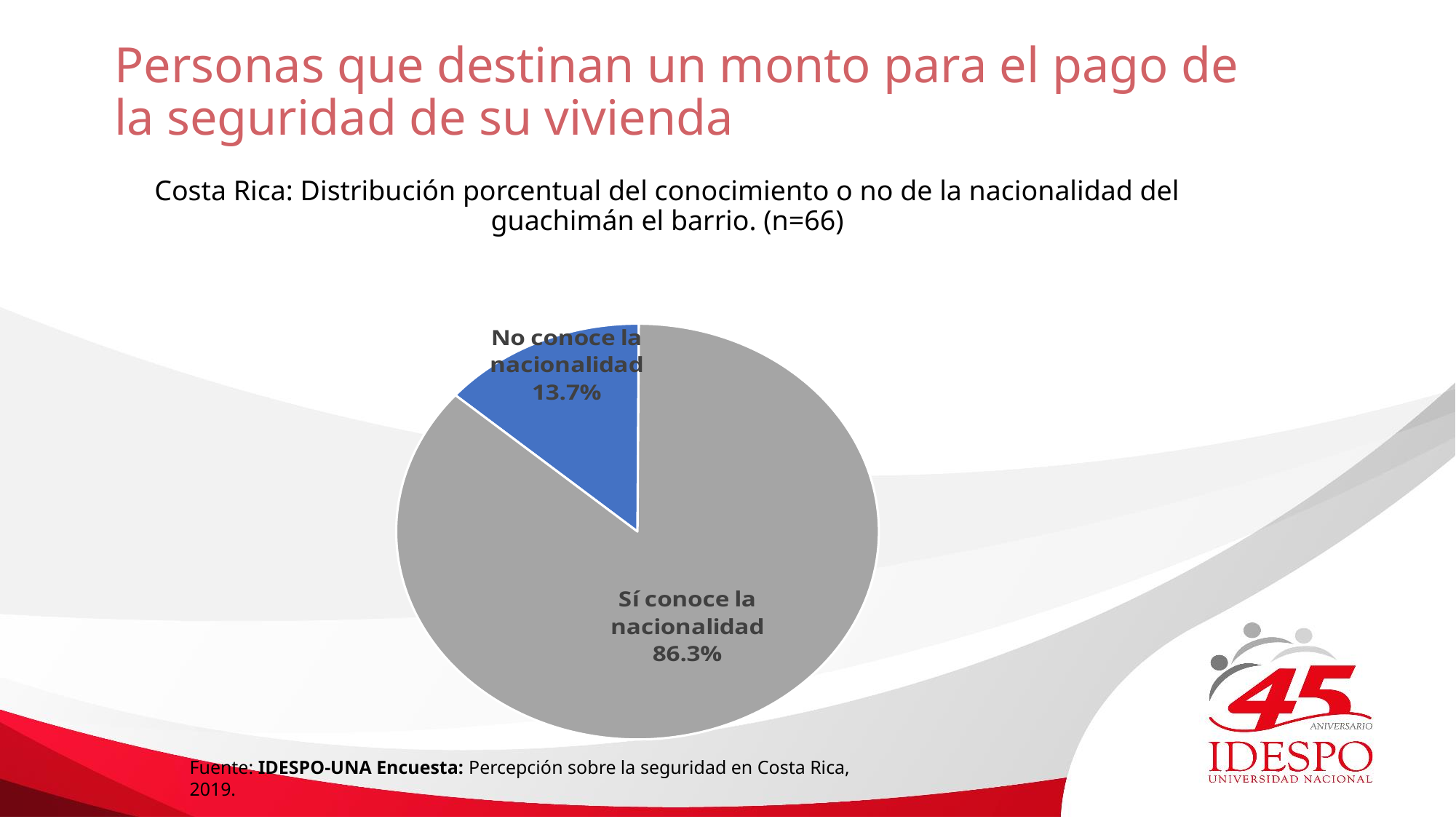
What percentage of respondents 'No conoce la nacionalidad'? 13.7% How many slices does the pie chart have? 2 Which slice of the pie is the largest? Sí conoce la nacionalidad What percentage of respondents 'Sí conoce la nacionalidad'? 86.3% What kind of chart is shown on the slide? pie chart What is the sample size (n) stated in the chart subtitle? 66 Which slice of the pie is the smallest? No conoce la nacionalidad What colour is the 'No conoce la nacionalidad' slice? blue Which is larger: the share for 'Sí conoce la nacionalidad' or for 'No conoce la nacionalidad'? Sí conoce la nacionalidad What share of the pie does the 'Sí conoce la nacionalidad' slice represent? 86.3% What is the difference in percentage points between 'Sí conoce la nacionalidad' and 'No conoce la nacionalidad'? 72.6